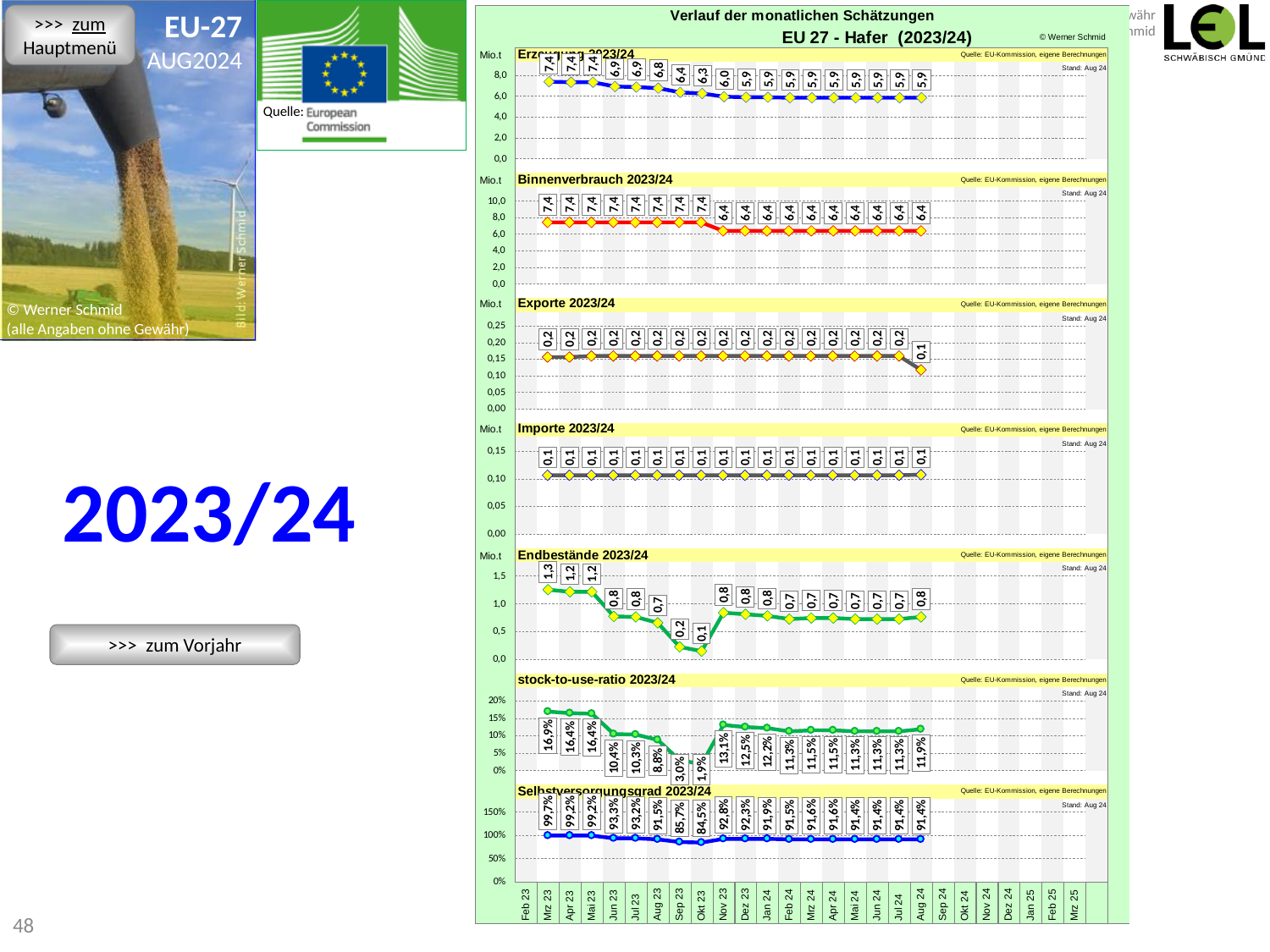
In the 'Erzeugung 2023/24' chart, what is the difference between the Mrz 23 value and the Aug 24 value? 1,5 In the 'Exporte 2023/24' chart, what is the value for Aug 24? 0,1 In the 'Endbestände 2023/24' chart, what is the value for Mrz 23? 1,3 In the 'Erzeugung 2023/24' chart, do the values rise or fall from Mrz 23 to Aug 24? fall In the 'Erzeugung 2023/24' chart, what is the value for Aug 24? 5,9 In the 'stock-to-use-ratio 2023/24' chart, which month has the highest value? Mrz 23 In the 'Erzeugung 2023/24' chart, what is the value for Mrz 23? 7,4 In the 'Binnenverbrauch 2023/24' chart, what is the value for Nov 23? 6,4 In the 'Binnenverbrauch 2023/24' chart, which is larger, the value for Mrz 23 or the value for Aug 24? Mrz 23 In the 'Selbstversorgungsgrad 2023/24' chart, what is the value for Okt 23? 84,5% What kind of chart is the 'Importe 2023/24' chart? line chart In the 'Endbestände 2023/24' chart, which month has the lowest value? Okt 23